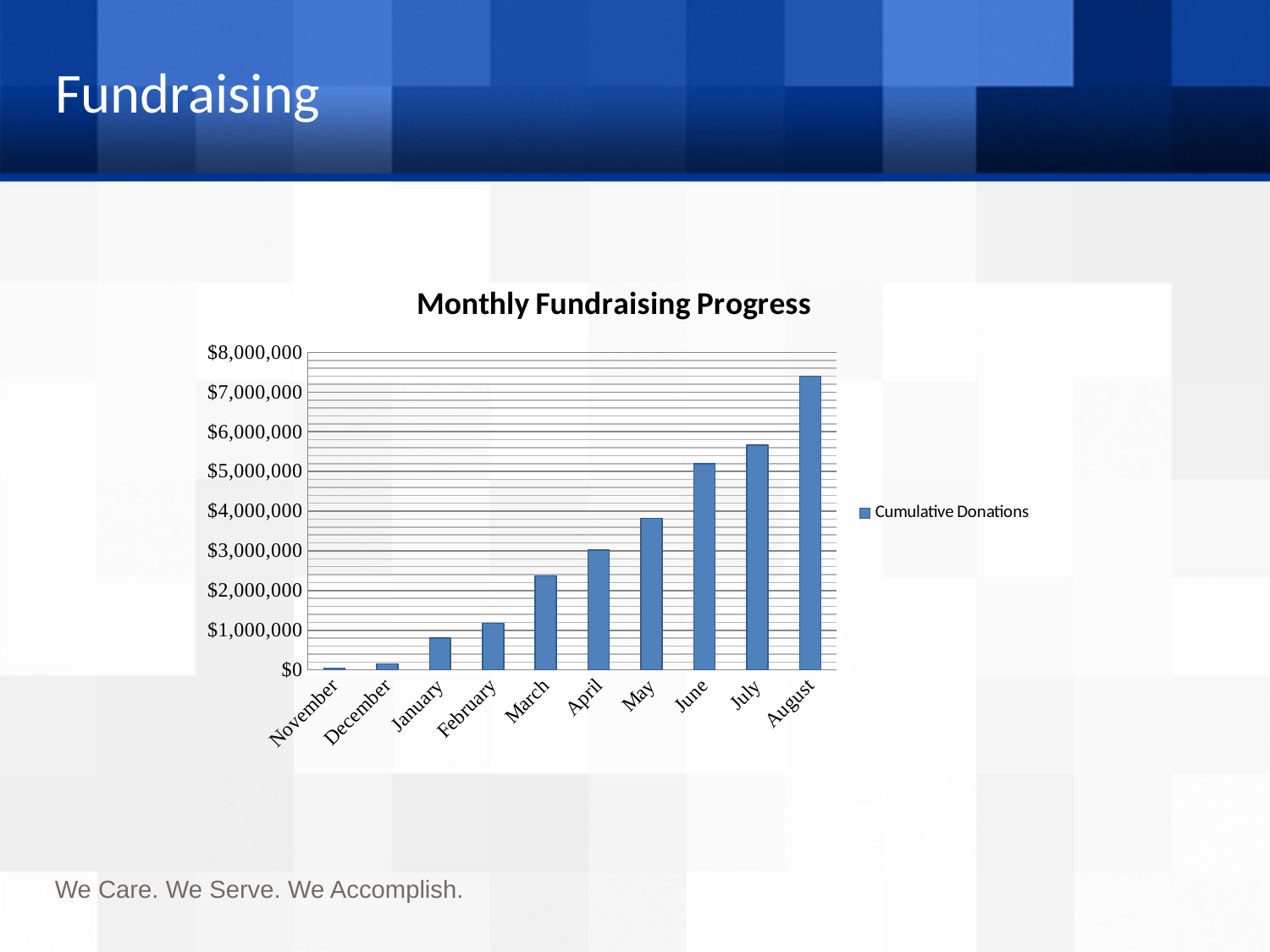
Do cumulative donations rise or fall from November to August? Rise Which month has the lowest cumulative donations? November Is the value for January greater or less than $1,000,000? less Is the value for August greater or less than $7,000,000? greater Is the value for June greater or less than $5,000,000? greater What is the title of the chart? Monthly Fundraising Progress How many months are shown on the x axis? 10 Which month has the highest cumulative donations? August What is the name of the series shown in the legend? Cumulative Donations What type of chart is shown on the slide? Bar chart How many series does the legend list? 1 Which month has larger cumulative donations, May or July? July